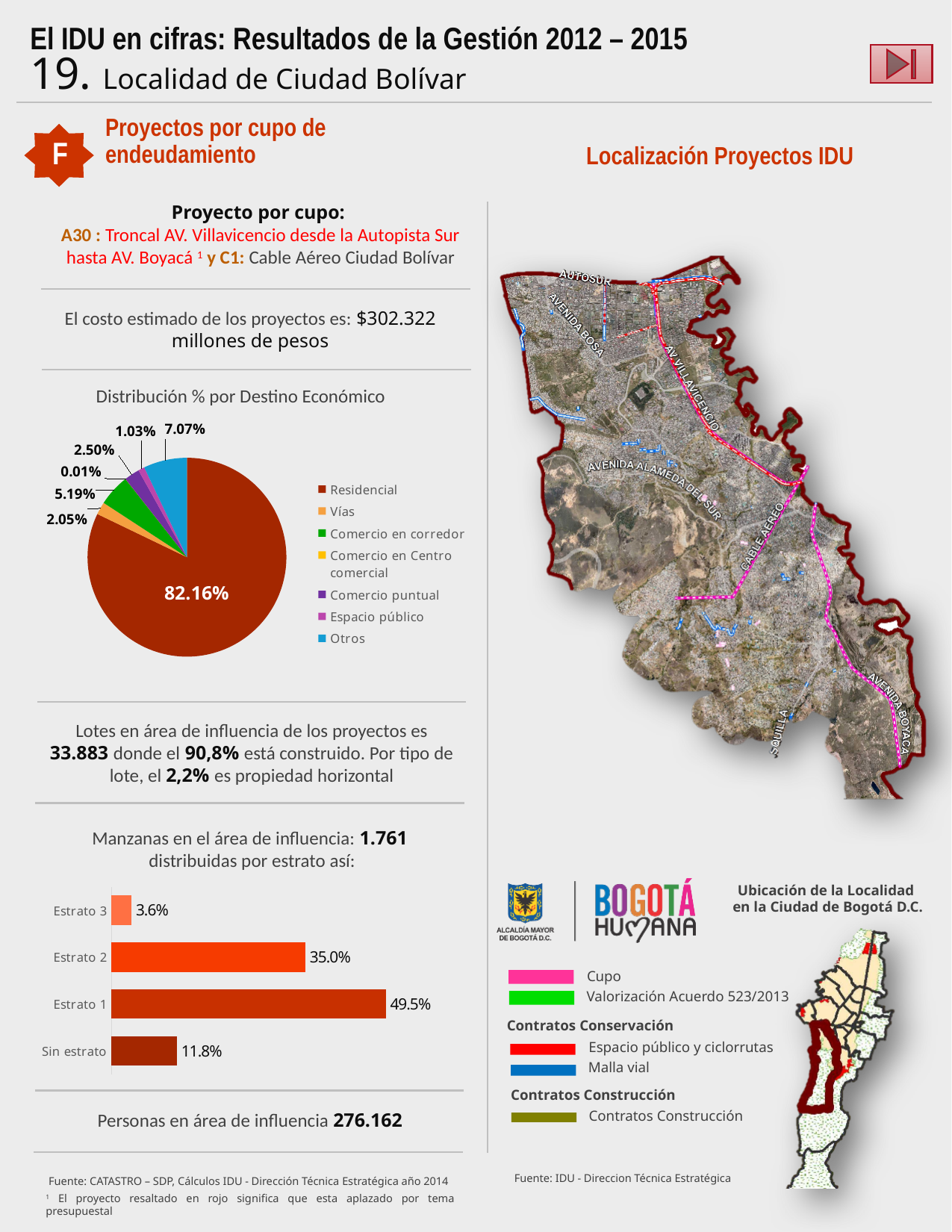
In the pie chart 'Distribución % por Destino Económico', what percentage is Residencial? 82.16% In the bar chart of Manzanas by estrato, what is the difference between Estrato 1 and Estrato 2? 14.5% In the pie chart 'Distribución % por Destino Económico', which category has the largest share? Residencial How many categories does the legend of the pie chart 'Distribución % por Destino Económico' list? 7 What type of chart is used to show Manzanas distributed by estrato? Bar chart In the bar chart of Manzanas by estrato, which category has the lowest value? Estrato 3 In the bar chart of Manzanas by estrato, what is the value for Estrato 1? 49.5% In the bar chart of Manzanas by estrato, what is the value for Sin estrato? 11.8% In the pie chart 'Distribución % por Destino Económico', what percentage is Comercio en corredor? 5.19% In the pie chart 'Distribución % por Destino Económico', which category has the smallest share? Comercio en Centro comercial In the pie chart 'Distribución % por Destino Económico', which is larger: Vías or Comercio puntual? Comercio puntual In the pie chart 'Distribución % por Destino Económico', what percentage is Otros? 7.07%